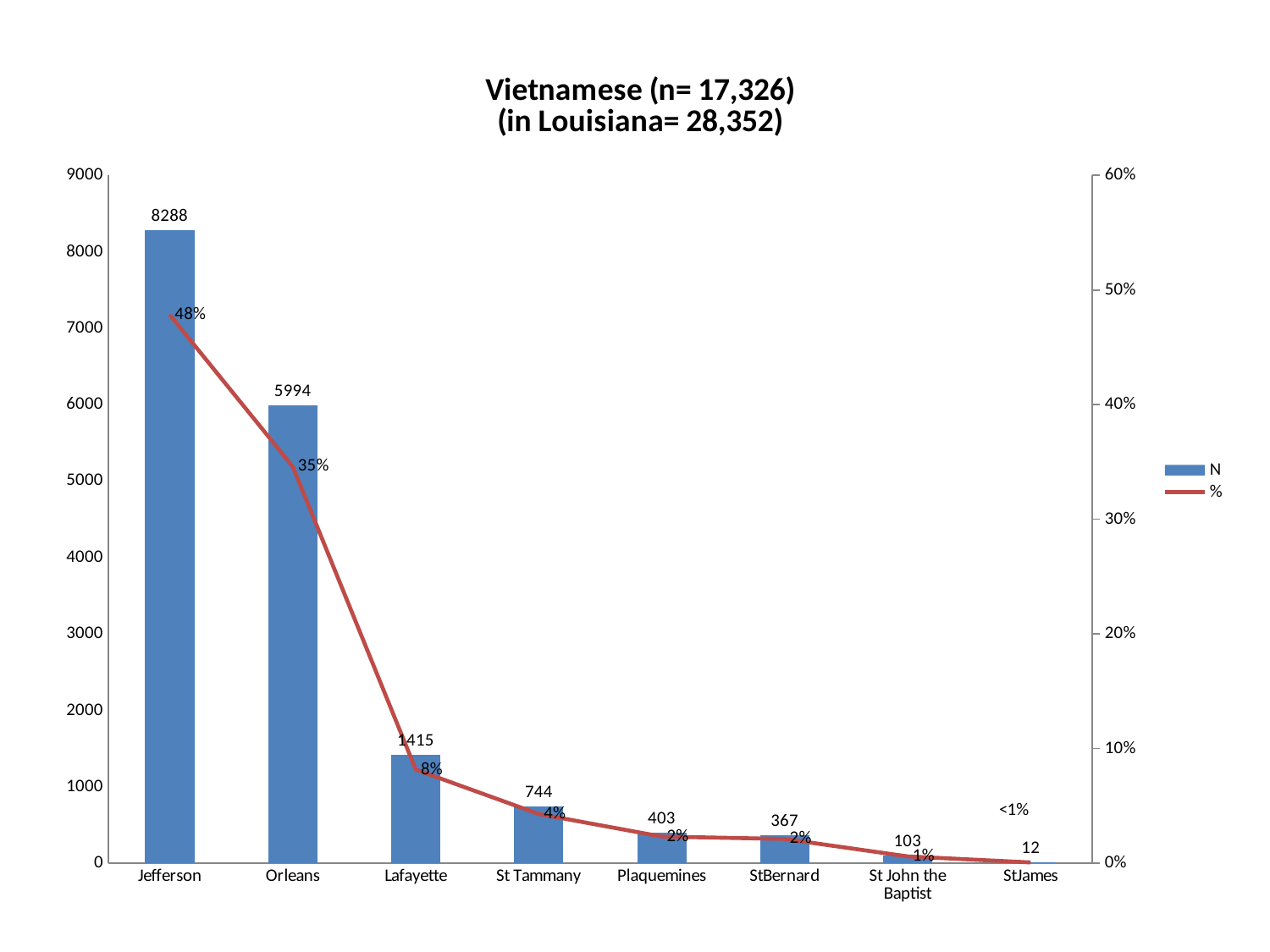
What percentage is shown for Orleans? 35% What is the N value for Lafayette? 1415 Which parish has the lowest N value? StJames What is the N value for St John the Baptist? 103 What is the N value for Jefferson? 8288 How many parishes are shown on the x axis? 8 Which has a larger N value, St Tammany or Plaquemines? St Tammany Which parish has the highest N value? Jefferson What is the difference in N between Jefferson and Orleans? 2294 What is the title of the chart? Vietnamese (n= 17,326) (in Louisiana= 28,352) How many series does the legend list? 2 Do the N values rise or fall from left to right along the x axis? fall